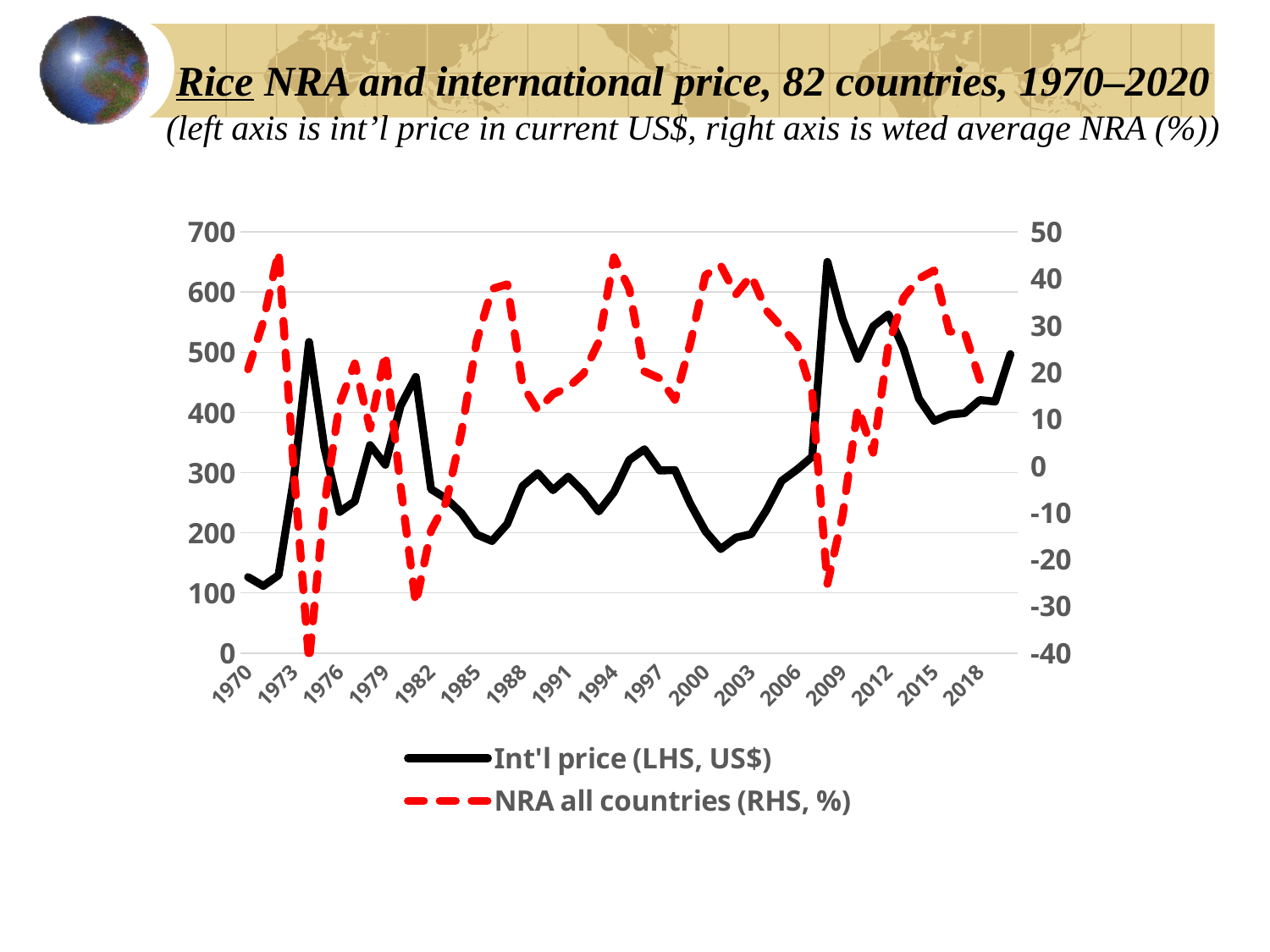
What is the title of the chart? Rice NRA and international price, 82 countries, 1970–2020 In which year does the Int'l price (LHS, US$) series reach its highest value? 2008 In which year does the NRA all countries (RHS, %) series reach its lowest value? 1974 Is the Int'l price (LHS, US$) value for 2008 greater or less than 600? greater Is the Int'l price (LHS, US$) value for 1970 greater or less than 200? less How many series does the legend list? 2 Which series is drawn as a dashed red line? NRA all countries (RHS, %) Is the NRA all countries (RHS, %) value for 1974 greater or less than -30? less Does the Int'l price (LHS, US$) series rise or fall between 2008 and 2010? fall What kind of chart is shown on the slide? line chart